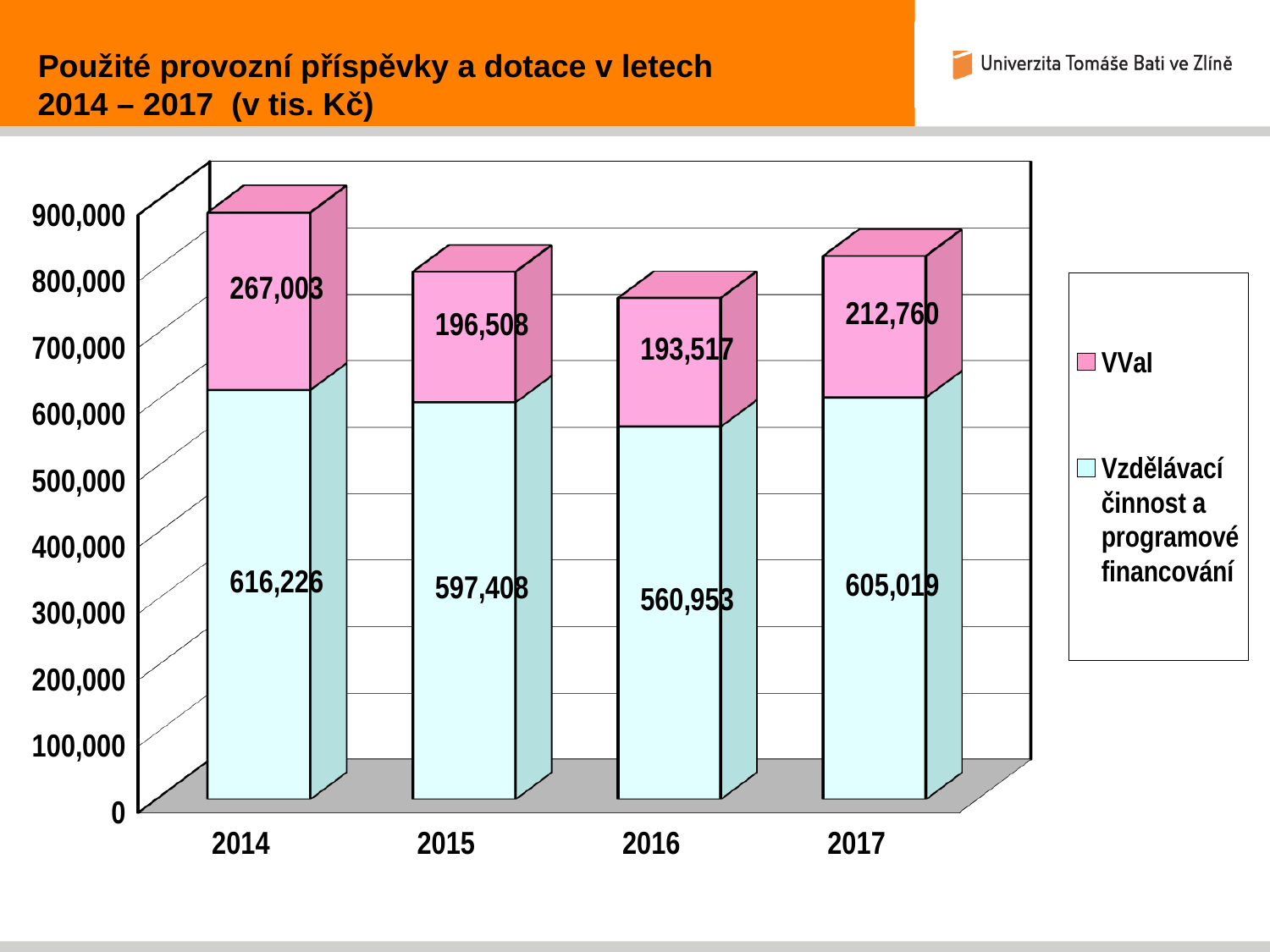
What is the value for Vzdělávací činnost a programové financování in 2016? 560,953 How many series does the legend list? 2 What is the value for VVaI in 2017? 212,760 What is the difference between the Vzdělávací činnost a programové financování values for 2014 and 2015? 18,818 In which year is the VVaI value the highest? 2014 How many years are shown on the x axis? 4 What kind of chart is shown on the slide? Stacked bar chart What is the total of the stacked bar for 2016? 754,470 In which year is the Vzdělávací činnost a programové financování value the lowest? 2016 What is the value for VVaI in 2014? 267,003 Which is larger, the VVaI value for 2015 or for 2016? 2015 What is the total of the stacked bar for 2014? 883,229